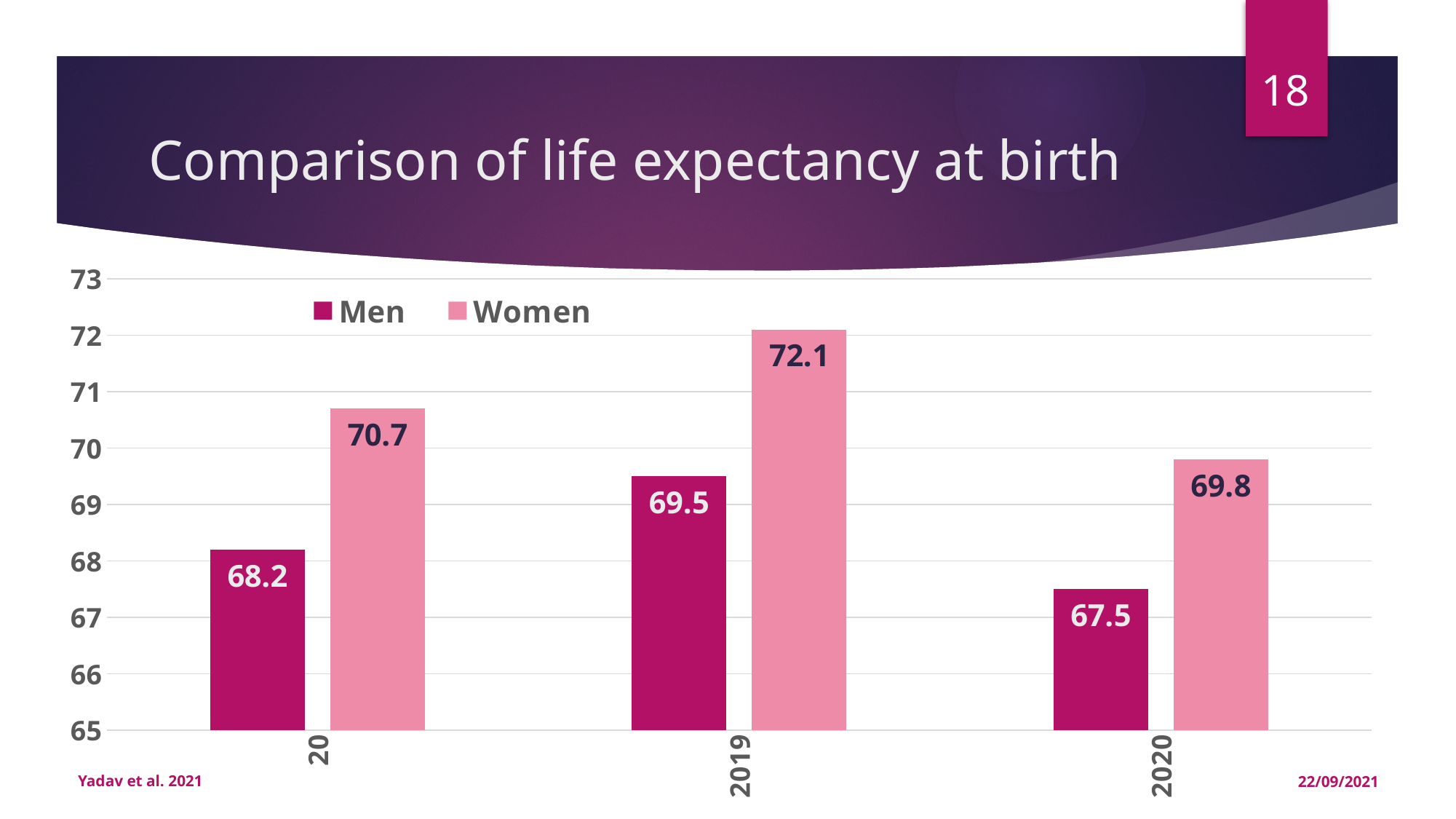
What kind of chart is shown on the slide? Bar chart What is the life expectancy value for Women in 2019? 72.1 What is the difference between the Women and Men values in 2020? 2.3 What is the value of the Women bar in the leftmost group of bars? 70.7 Which year has the lowest value for Men? 2020 Which is larger, the Men value in 2019 or the Men value in 2020? Men in 2019 What is the title of the chart? Comparison of life expectancy at birth What is the difference between the Women and Men values in 2019? 2.6 What is the life expectancy value for Men in 2019? 69.5 What is the life expectancy value for Men in 2020? 67.5 Which year has the highest value for Women? 2019 How many series does the legend list? 2